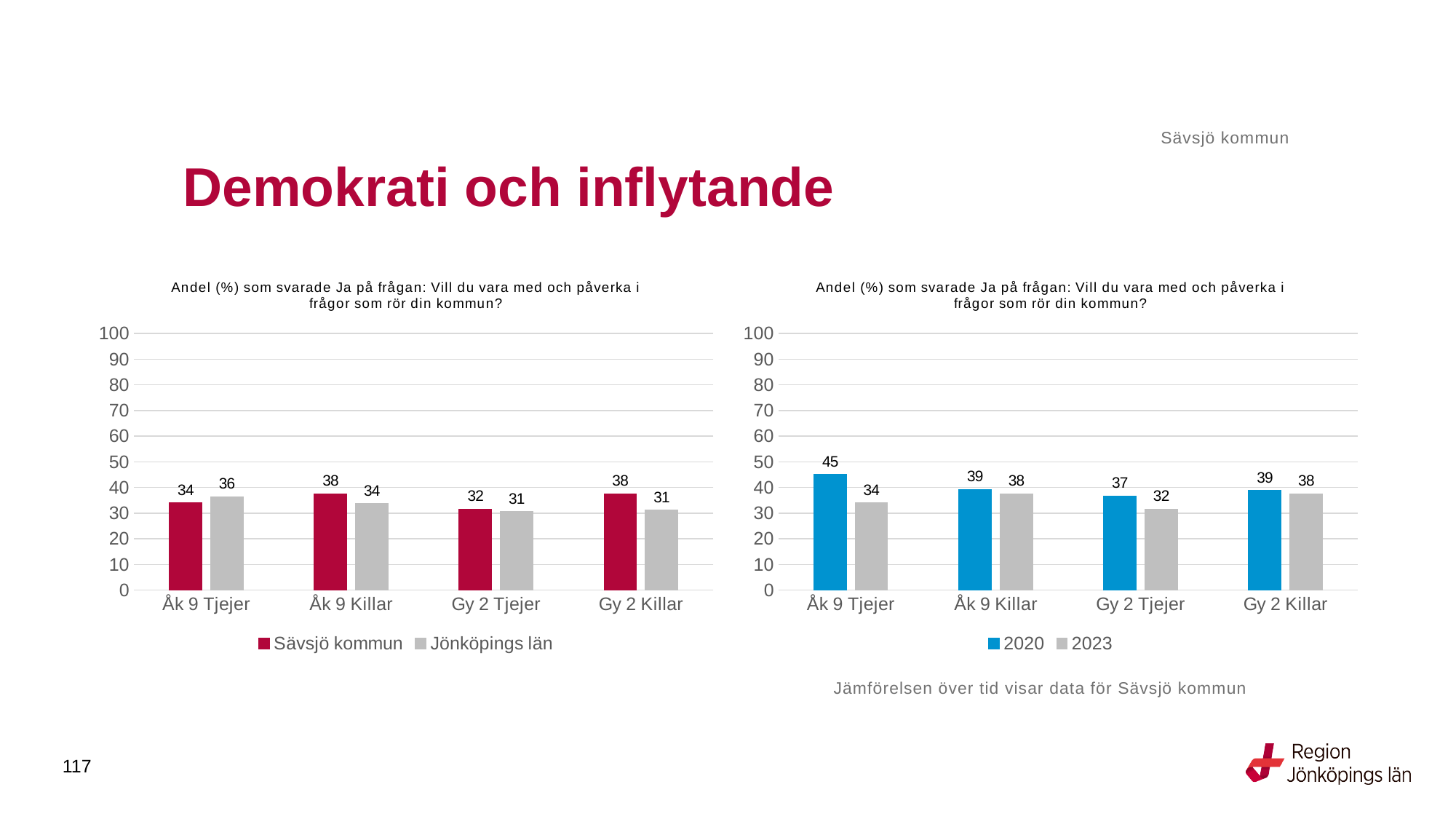
In the right chart, which category has the highest value for 2020? Åk 9 Tjejer In the left chart, what is the value for Sävsjö kommun for Åk 9 Tjejer? 34 In the left chart, what is the value for Jönköpings län for Gy 2 Killar? 31 In the left chart, which is larger for Åk 9 Tjejer: Sävsjö kommun or Jönköpings län? Jönköpings län In the right chart, what is the difference between 2020 and 2023 for Åk 9 Tjejer? 11 In the right chart, how many categories are shown on the x axis? 4 What kind of chart is the right chart? Bar chart In the right chart, what is the value for 2023 for Gy 2 Tjejer? 32 In the right chart, what is the value for 2020 for Åk 9 Tjejer? 45 In the left chart, what is the difference between Sävsjö kommun and Jönköpings län for Gy 2 Killar? 7 In the left chart, how many series does the legend list? 2